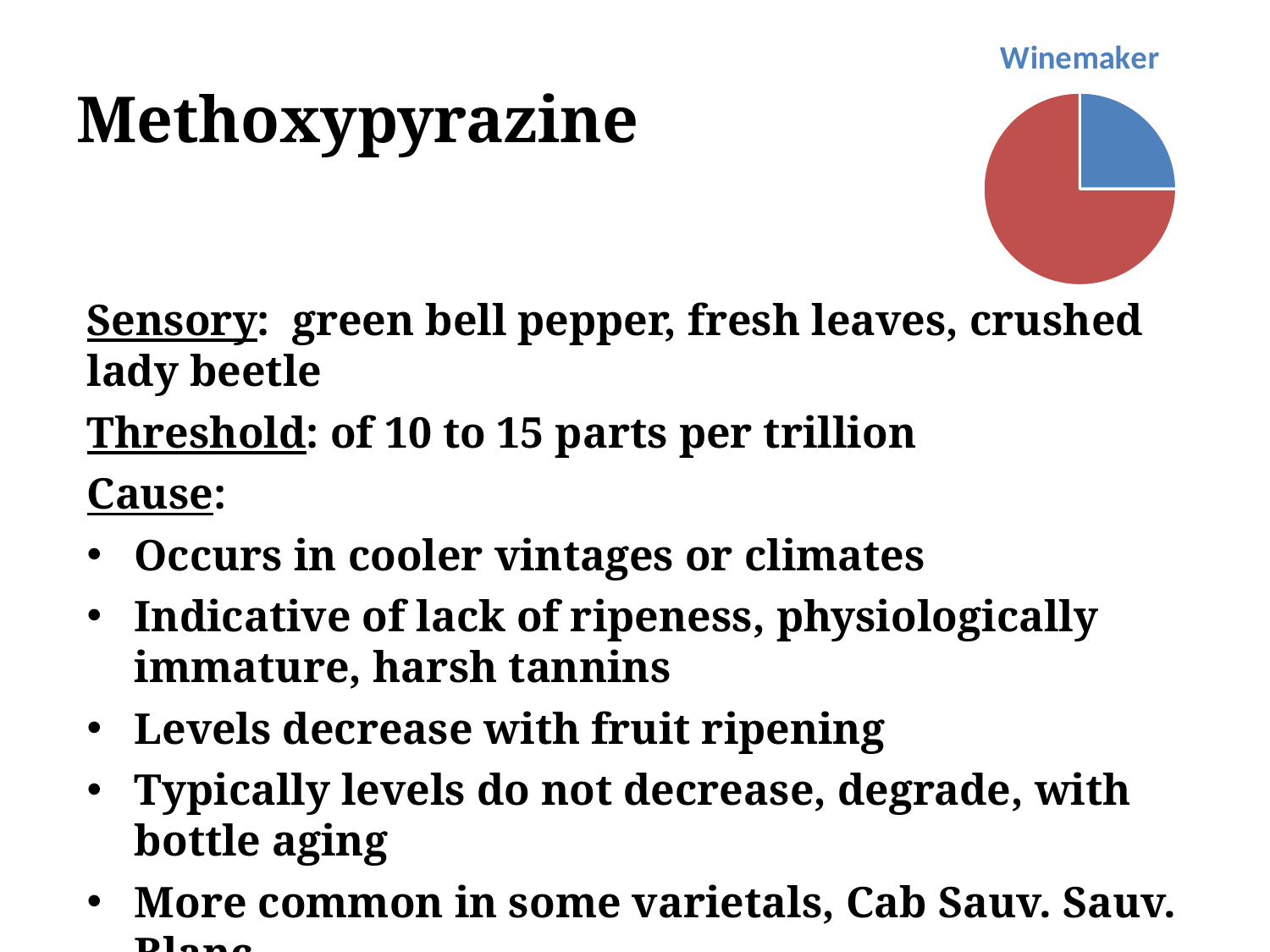
How many slices does the Winemaker pie chart have? 2 What two colours are used for the slices of the Winemaker pie chart? red and blue What is the title of the pie chart? Winemaker In the Winemaker pie chart, which colour is the largest slice? red What kind of chart is shown in the top right of the slide? pie chart In the Winemaker pie chart, which colour is the smallest slice? blue In the Winemaker pie chart, which slice is larger, the red one or the blue one? red